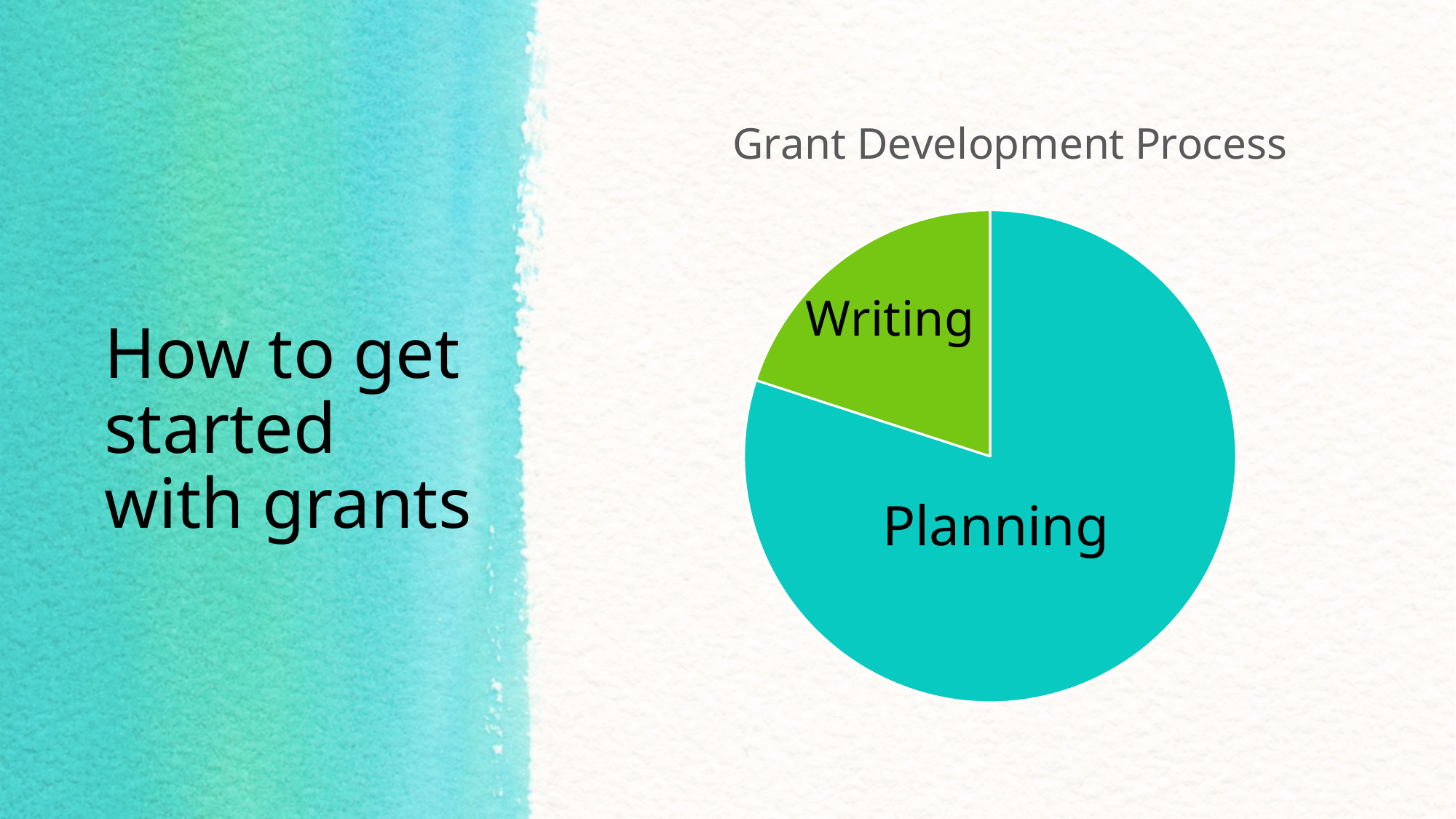
Which slice of the pie chart is the largest? Planning Does the Planning slice take up more or less than half of the pie? more Which slice is larger, Planning or Writing? Planning What is the title of the chart? Grant Development Process What kind of chart is shown on the slide? pie chart How many slices does the pie chart have? 2 What colour is the Writing slice? green Which slice of the pie chart is the smallest? Writing